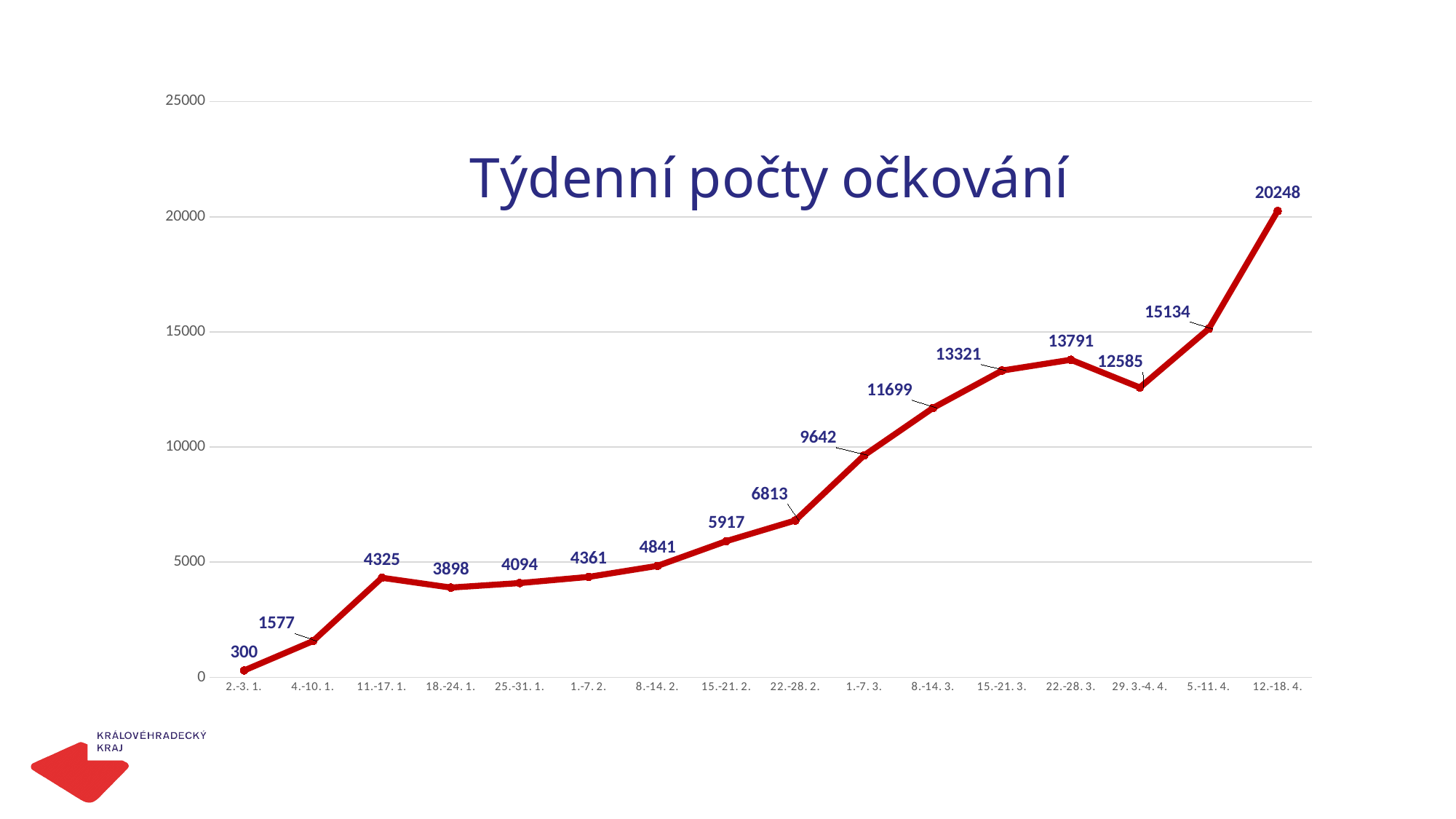
What is the difference between the values for 12.-18. 4. and 5.-11. 4.? 5114 Which week has the lowest value? 2.-3. 1. What type of chart is shown on the slide? line chart Which week has the highest value? 12.-18. 4. What is the title of the chart? Týdenní počty očkování Is the value for 8.-14. 3. greater or less than 10000? greater How many weeks are plotted on the x axis? 16 What is the value for the week 12.-18. 4.? 20248 What is the value for the week 1.-7. 3.? 9642 Which is larger, the value for 22.-28. 3. or the value for 29. 3.-4. 4.? 22.-28. 3. What is the value for the week 2.-3. 1.? 300 Do the values generally rise or fall from left to right along the x axis? rise